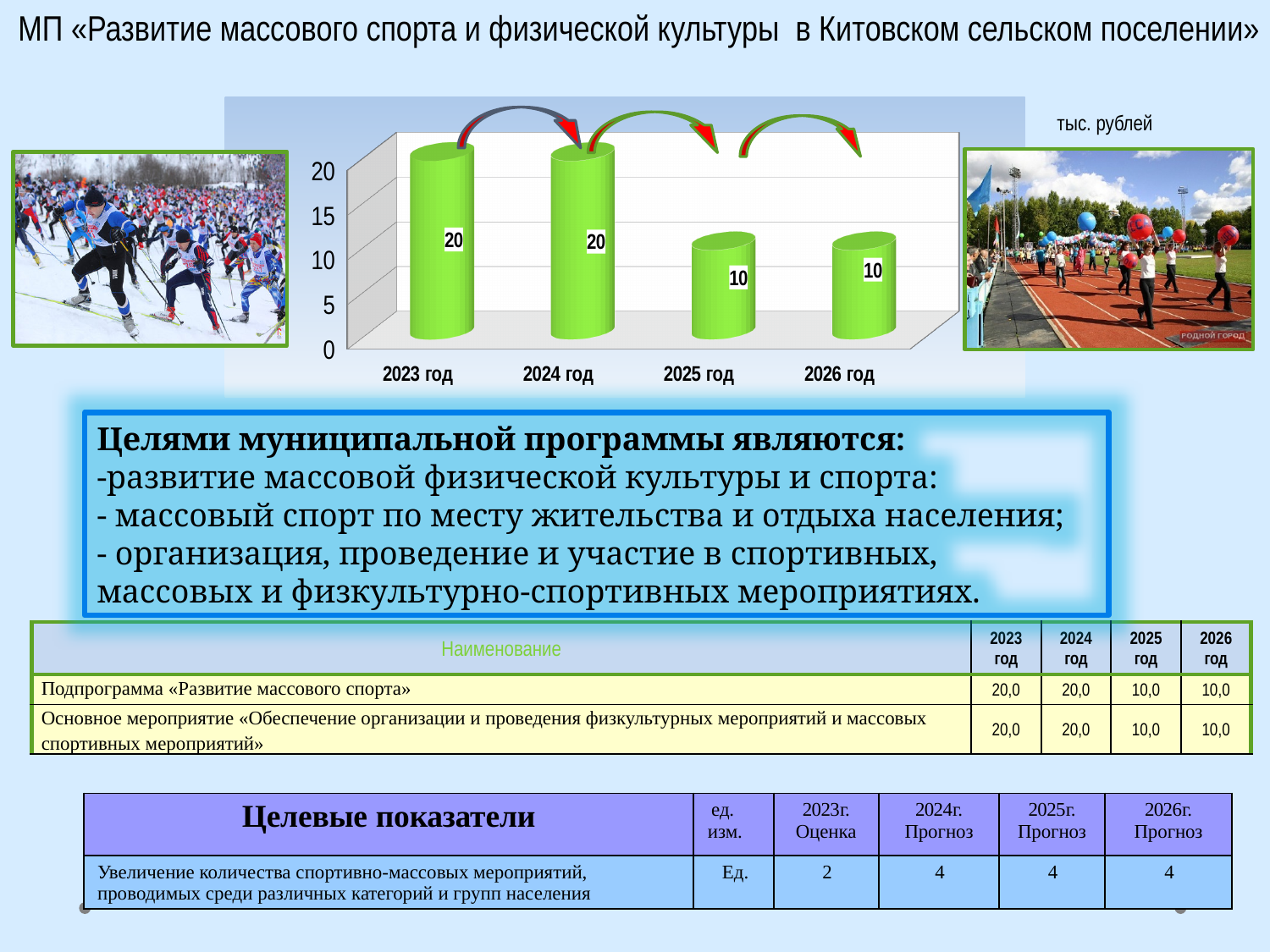
How many categories are shown on the x axis of the chart? 4 What is the value for 2026 год in the chart? 10 What kind of chart is shown on the slide? bar chart What unit is indicated next to the chart? тыс. рублей Is the value for 2024 год greater or less than 15? greater What is the value for 2024 год in the chart? 20 Do the values rise or fall from 2023 год to 2026 год? fall What is the difference between the values for 2024 год and 2025 год? 10 Which is larger, the value for 2023 год or the value for 2026 год? 2023 год What is the value for 2023 год in the chart? 20 What is the value for 2025 год in the chart? 10 Is the value for 2025 год greater or less than 15? less